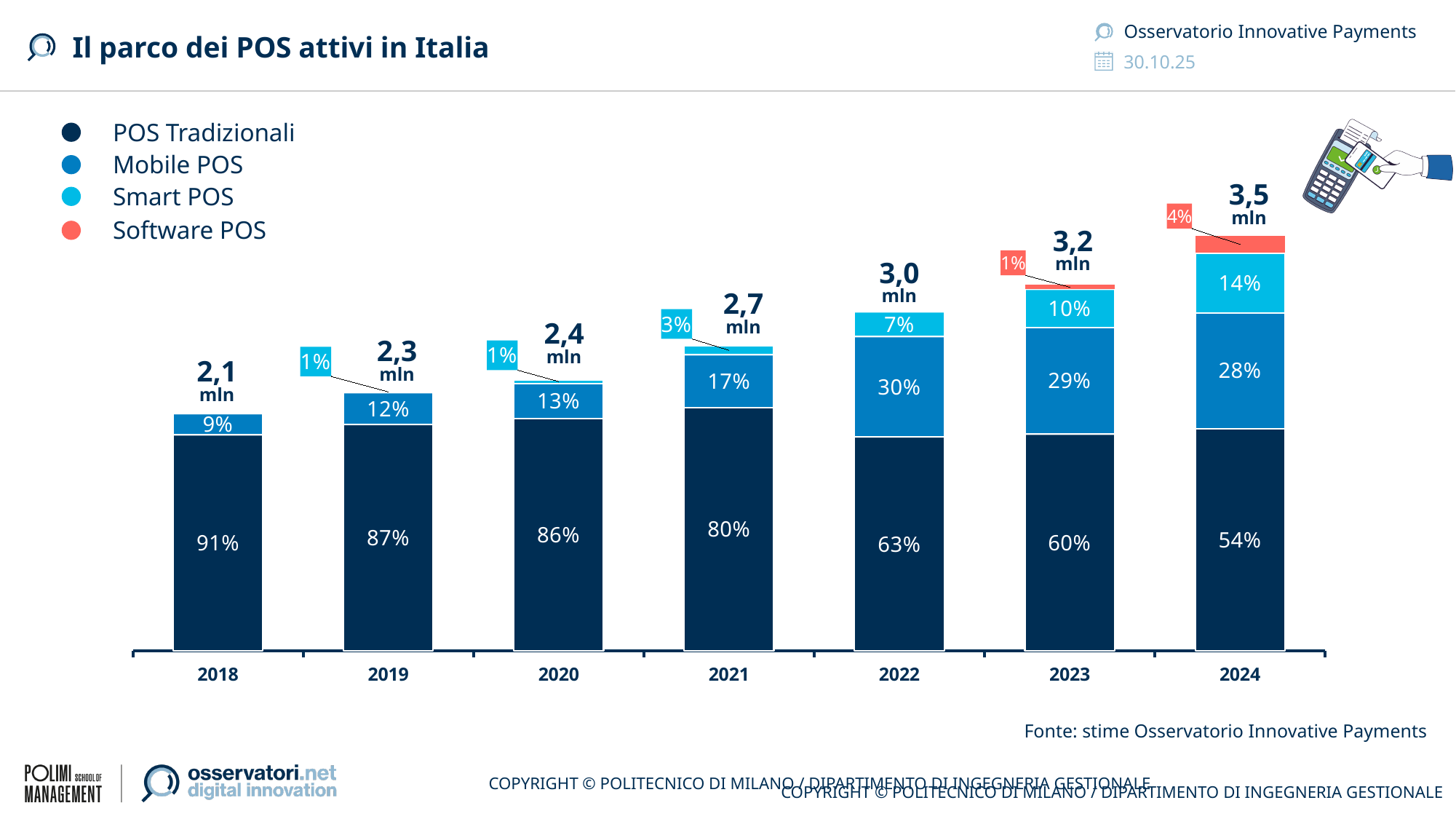
By how many percentage points did the POS Tradizionali share fall from 2018 to 2024? 37 percentage points How many series does the legend list? 4 How many years are shown on the x axis? 7 Which year has the lowest total of active POS? 2018 What is the Smart POS share in 2023? 10% What is the total number of active POS shown for 2021? 2,7 mln What is the Mobile POS share in 2022? 30% Which year has the highest total of active POS? 2024 What share of active POS in 2024 are POS Tradizionali? 54% Which is larger in 2023: the Mobile POS share or the Smart POS share? Mobile POS What kind of chart is shown on the slide? Stacked bar chart Does the total number of active POS rise or fall from 2018 to 2024? Rise